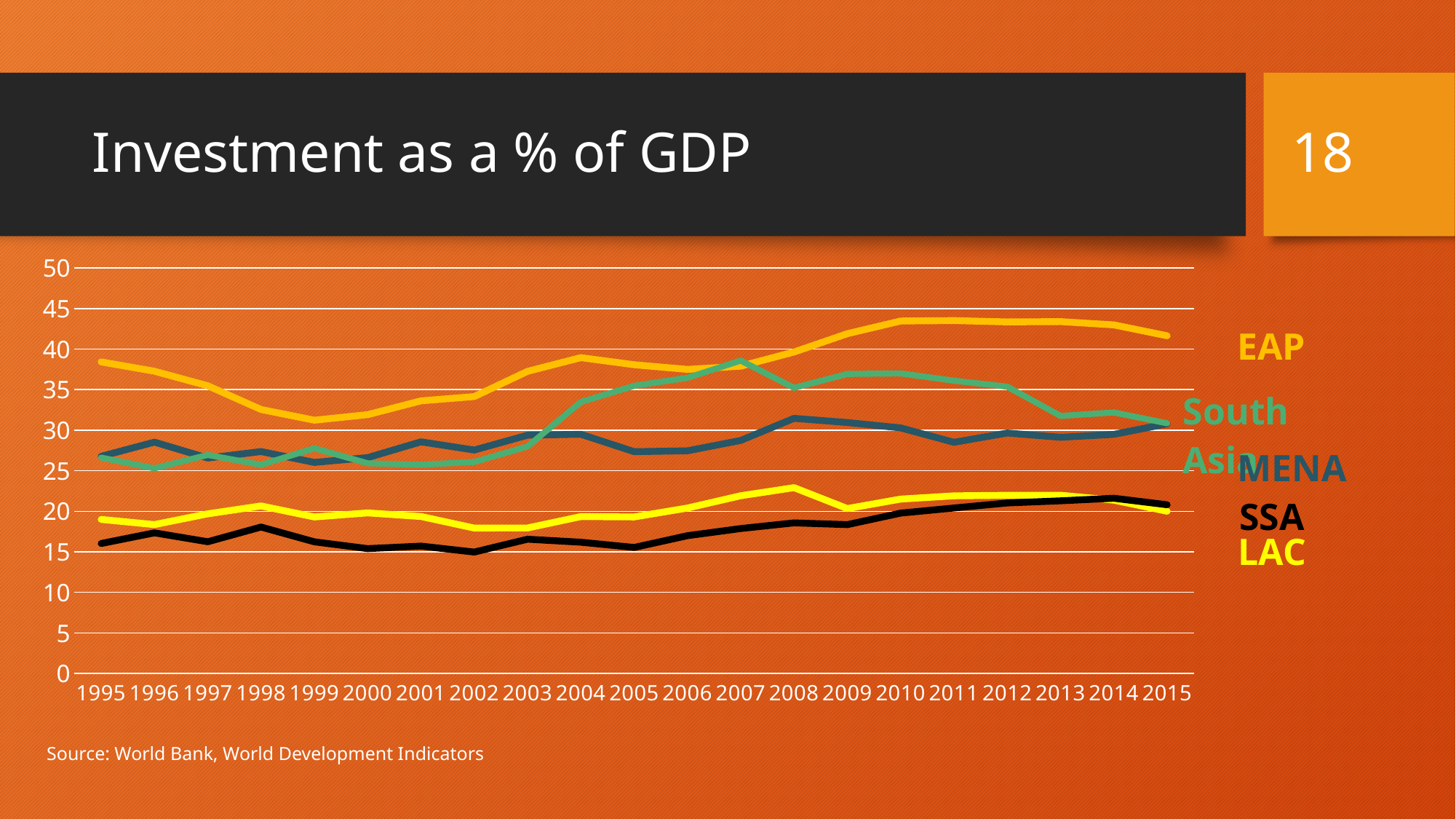
Is the value for LAC in 2008 greater or less than 20? greater Is the value for EAP in 2010 greater or less than 40? greater What source is cited for the chart data? World Bank, World Development Indicators How many years are shown along the x axis of the chart? 21 How many series (regions) are plotted on the chart? 5 Is the value for South Asia in 2007 greater or less than 35? greater Which region has the highest investment as a % of GDP in 2015? EAP What is the title of the chart on the slide? Investment as a % of GDP Which region has the lowest investment as a % of GDP in 1995? SSA Which is larger in 2010, the value for South Asia or the value for MENA? South Asia Does the EAP line rise or fall between 2003 and 2010? rise What kind of chart is shown on the slide? line chart